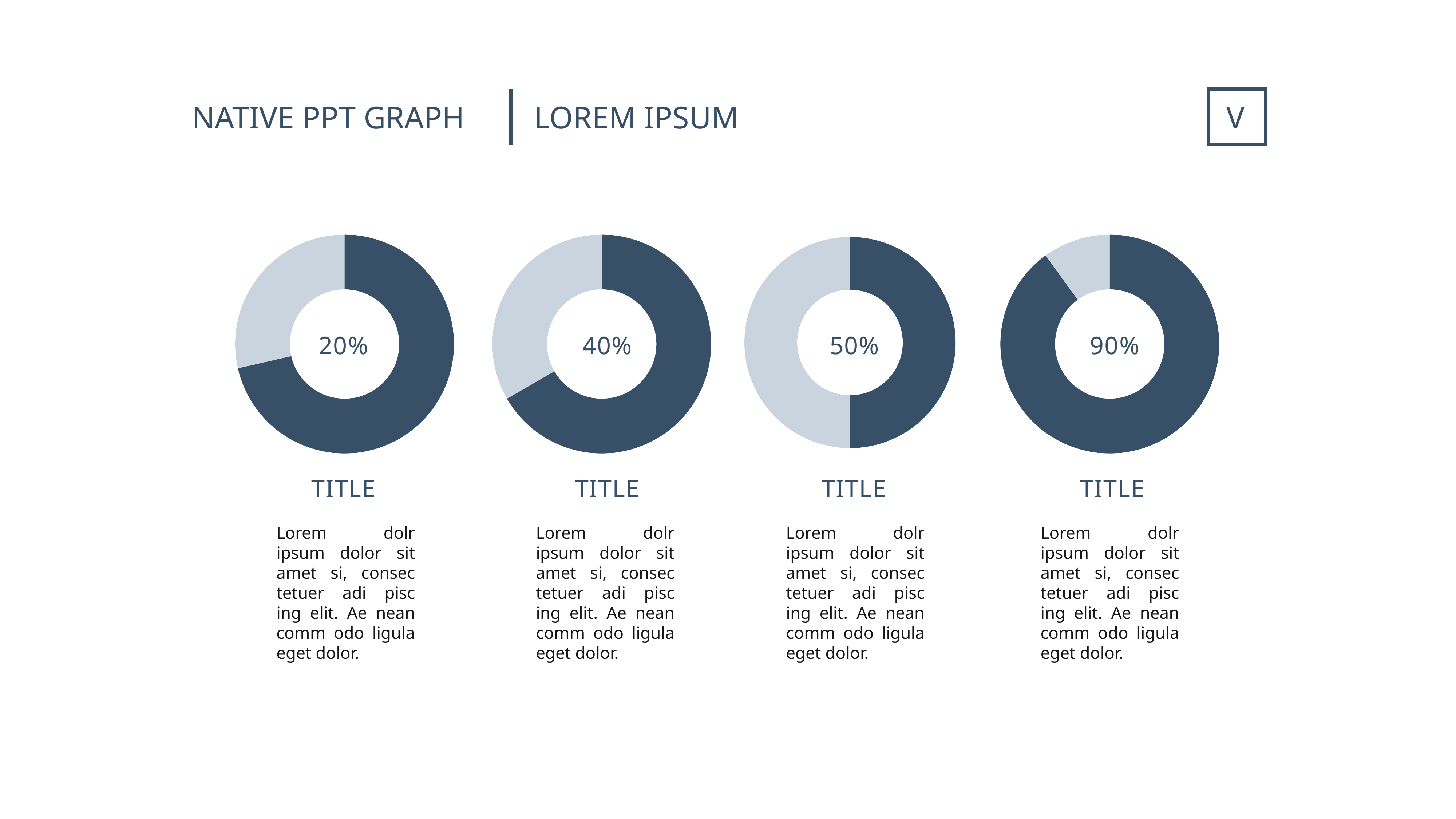
Do the percentages shown in the donut charts increase or decrease from left to right across the slide? Increase Which donut chart shows the highest percentage in its centre? The rightmost chart (90%) Which is larger: the percentage in the second donut chart from the left or the percentage in the third donut chart from the left? The third chart (50%) How many donut charts are shown on the slide? 4 What percentage is shown in the centre of the third donut chart from the left? 50% What percentage is shown in the centre of the rightmost donut chart? 90% What percentage is shown in the centre of the leftmost donut chart? 20% What kind of chart is used for each of the four graphics on the slide? Donut chart What is the heading text at the top left of the slide? NATIVE PPT GRAPH What is the difference between the percentage in the rightmost donut chart and the percentage in the leftmost donut chart? 70% What percentage is shown in the centre of the second donut chart from the left? 40% Which donut chart shows the lowest percentage in its centre? The leftmost chart (20%)